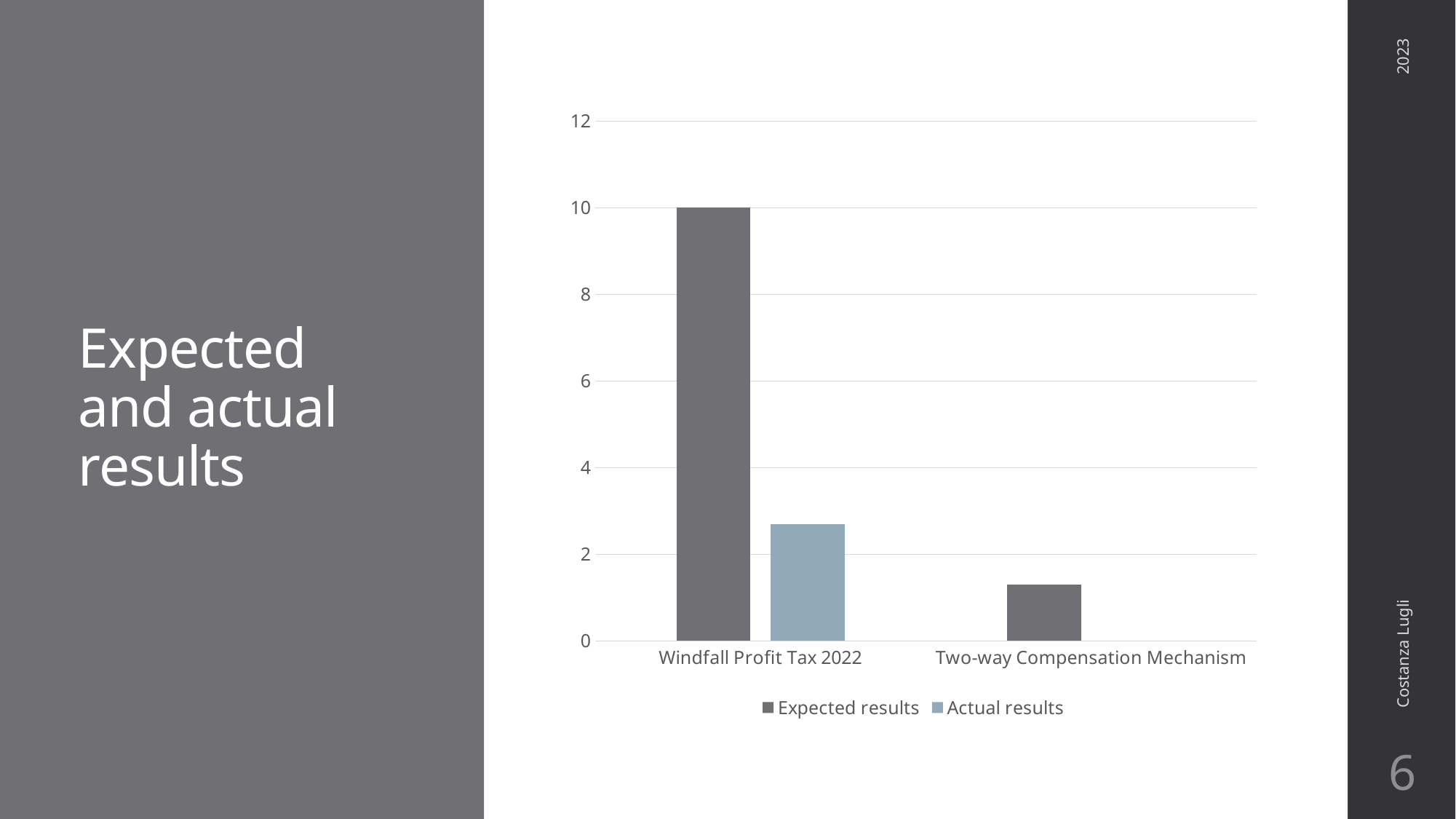
Is the Expected results value for Two-way Compensation Mechanism greater or less than 2? less Is the Actual results value for Windfall Profit Tax 2022 greater or less than 2? greater What kind of chart is shown on the slide? Bar chart Which category has the lowest Expected results value? Two-way Compensation Mechanism How many categories are shown on the x axis of the chart? 2 What are the two series named in the chart's legend? Expected results and Actual results What is the Expected results value for Windfall Profit Tax 2022? 10 Is the Actual results value for Windfall Profit Tax 2022 greater or less than 4? less Which category has the higher Expected results value? Windfall Profit Tax 2022 What is the title of the slide containing the chart? Expected and actual results For Windfall Profit Tax 2022, which is larger: Expected results or Actual results? Expected results How many series does the chart's legend list? 2